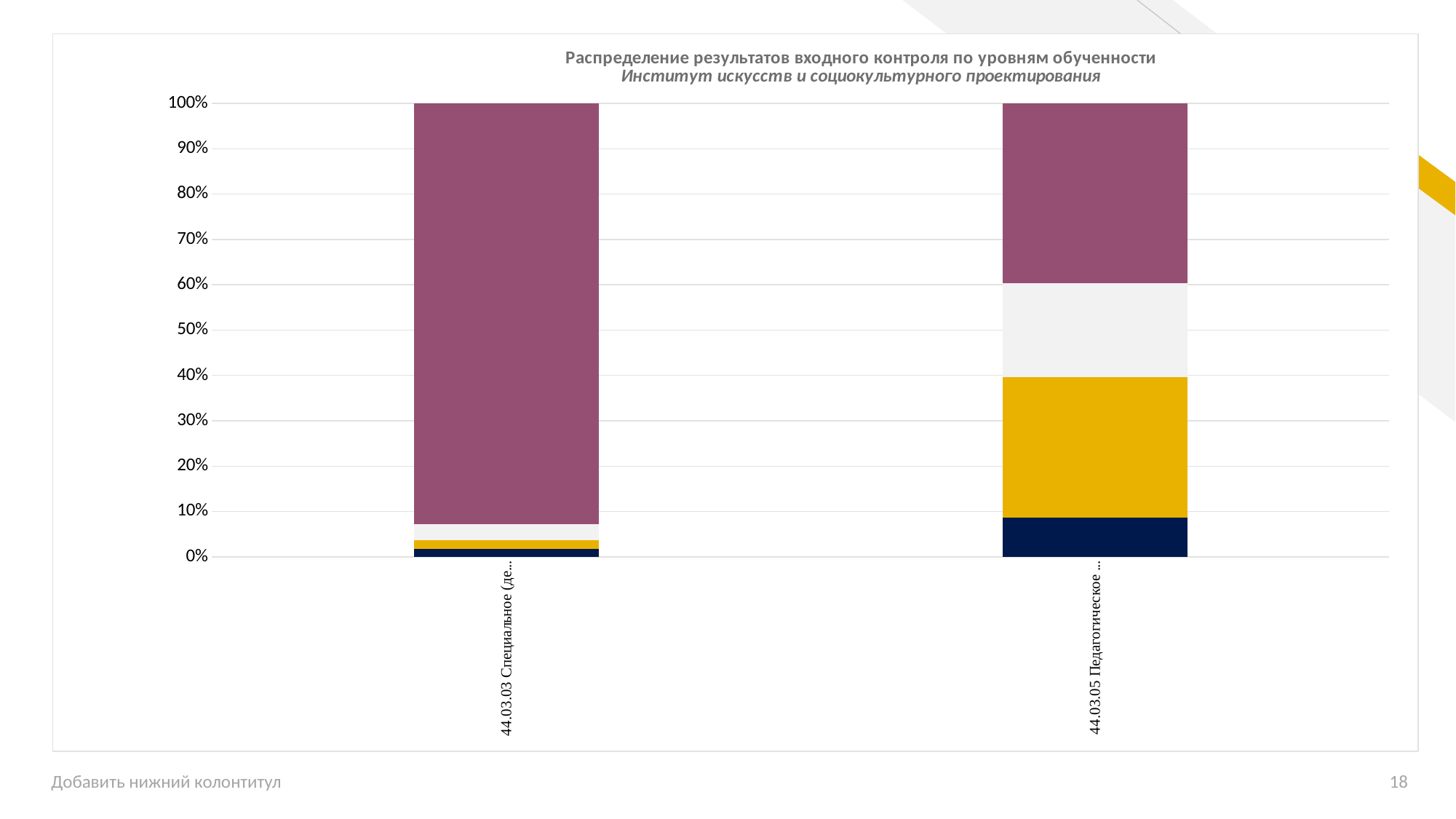
How many categories (bars) are shown on the x axis? 2 Which bar has the larger purple (top) segment, 44.03.03 Специальное or 44.03.05 Педагогическое? 44.03.03 Специальное Is the dark navy (bottom) segment of the bar for 44.03.05 Педагогическое greater or less than 10%? less Which bar has the larger light gray segment, 44.03.03 Специальное or 44.03.05 Педагогическое? 44.03.05 Педагогическое Is the dark navy (bottom) segment of the bar for 44.03.03 Специальное greater or less than 10%? less What is the title of the chart? Распределение результатов входного контроля по уровням обученности Is the purple (top) segment of the bar for 44.03.03 Специальное greater or less than 90%? greater What kind of chart is shown on the slide? Stacked bar chart Which institute is named in the chart subtitle? Институт искусств и социокультурного проектирования Which bar has the larger gold segment, 44.03.03 Специальное or 44.03.05 Педагогическое? 44.03.05 Педагогическое What is the total height of the stacked bar for 44.03.03 Специальное? 100% What is the total height of the stacked bar for 44.03.05 Педагогическое? 100%